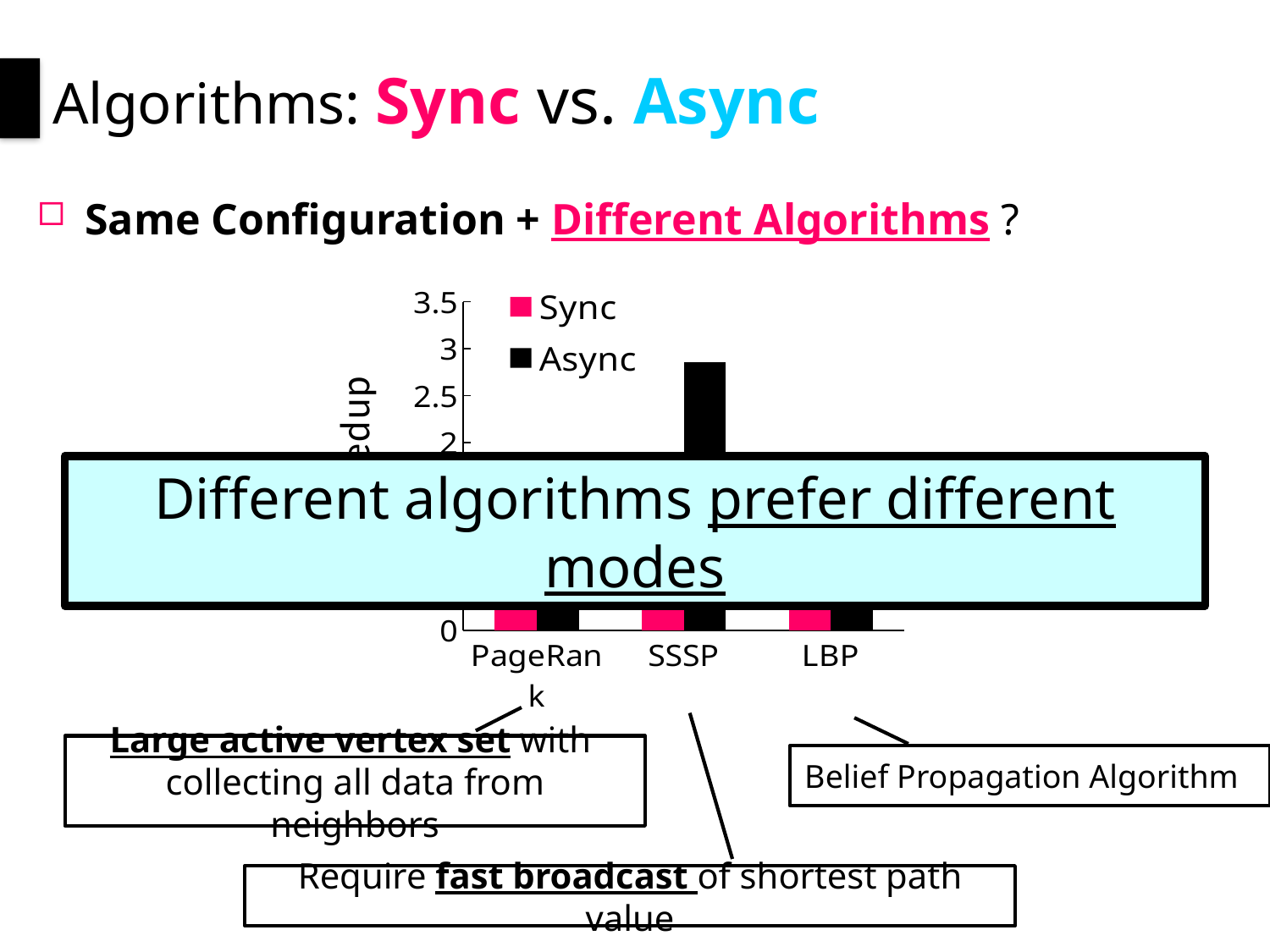
Which is larger, the Async value for SSSP or the Async value for PageRank? SSSP What is the highest tick value shown on the y axis of the chart? 3.5 Is the Async value for SSSP greater or less than 2.5? greater What kind of chart is shown on the slide? bar chart Which is larger, the Async value for SSSP or the Async value for LBP? SSSP What are the two series named in the chart's legend? Sync and Async How many series does the chart's legend list? 2 Is the Async value for SSSP greater or less than 3? less Is the Async value for LBP greater or less than 2.5? less Which category has the highest Async value? SSSP Which colour represents the Async series in the chart? black How many categories are shown on the x axis of the chart? 3